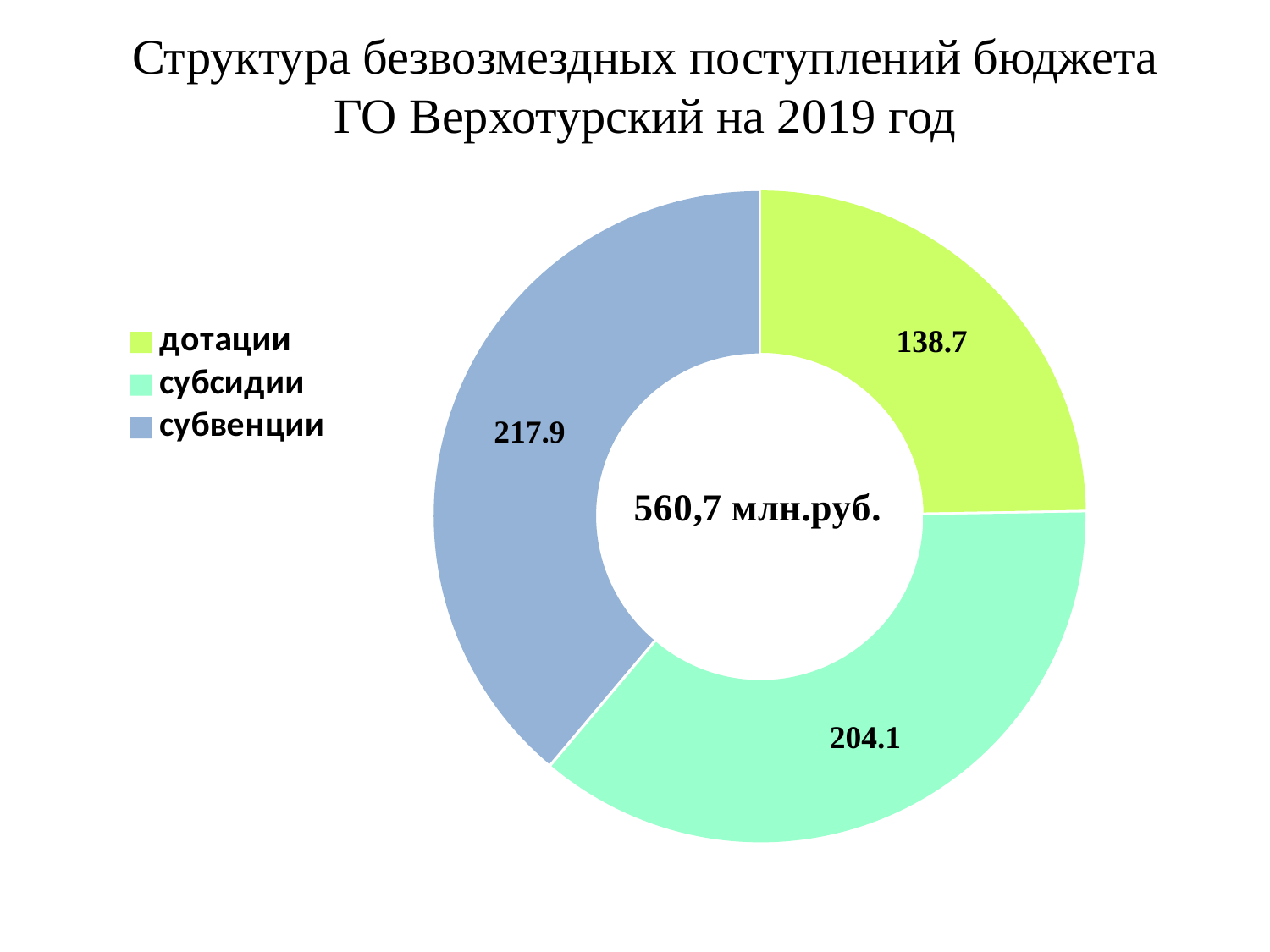
What is the value for дотации? 138.7 Which category has the smallest value? дотации How many categories does the chart show? 3 What total is printed in the centre of the chart? 560,7 млн.руб. What colour is the segment for субвенции? blue (grey-blue) What is the difference between the values for субвенции and субсидии? 13.8 What is the difference between the values for субсидии and дотации? 65.4 What is the value for субвенции? 217.9 Which is larger, the value for субвенции or the value for дотации? субвенции Which category has the largest value? субвенции What is the value for субсидии? 204.1 What kind of chart is shown on the slide? doughnut (pie) chart